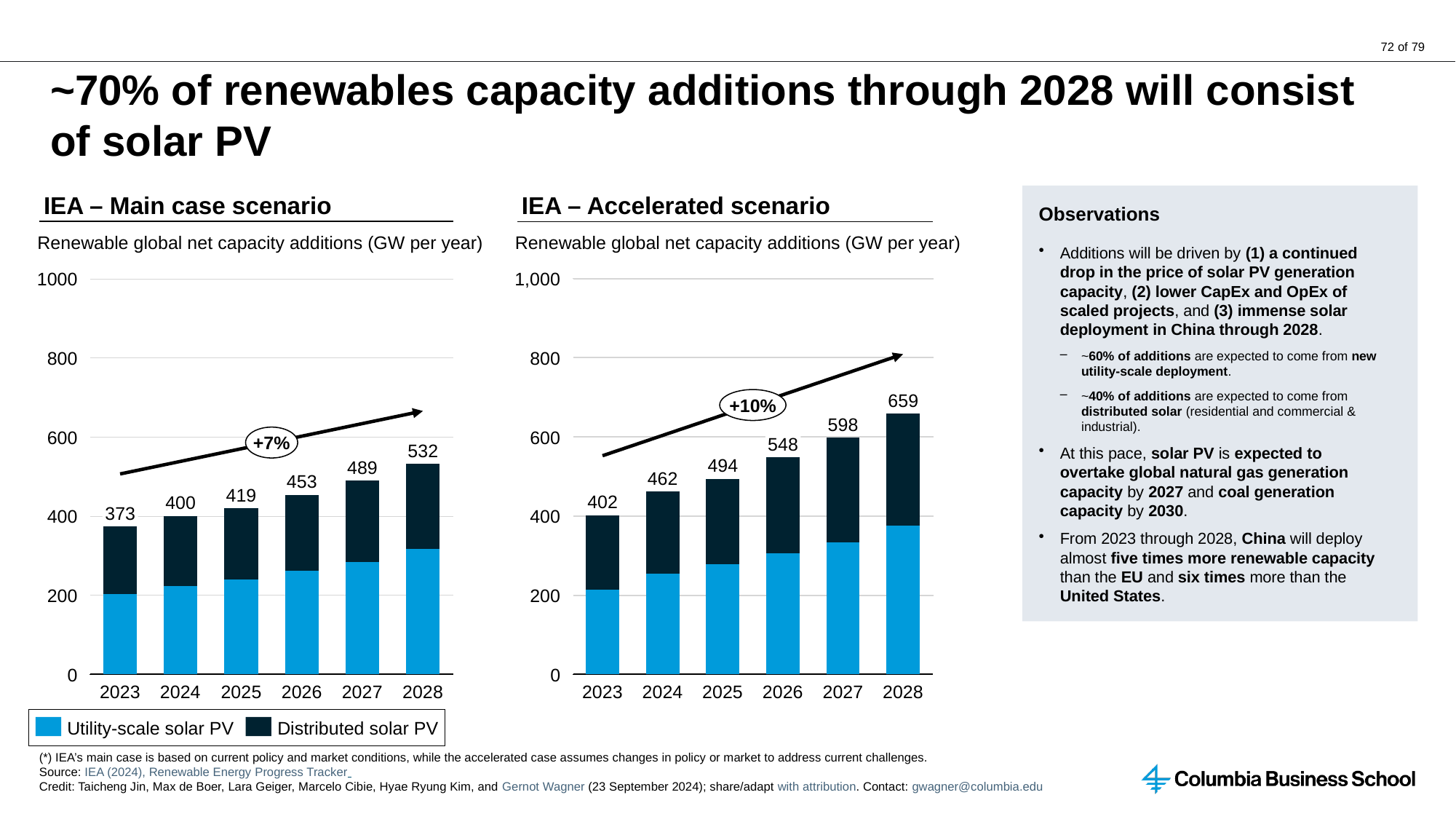
In the IEA – Main case scenario chart, do the total capacity additions rise or fall from 2023 to 2028? Rise In the IEA – Main case scenario chart, which year has the lowest total capacity addition? 2023 In the IEA – Accelerated scenario chart, what is the total renewable net capacity addition labelled for 2023? 402 Which is larger: the 2026 total in the IEA – Main case scenario chart or the 2026 total in the IEA – Accelerated scenario chart? IEA – Accelerated scenario (548) How many years are shown on the x axis of the IEA – Main case scenario chart? 6 In the IEA – Main case scenario chart, what is the difference between the 2028 total and the 2023 total? 159 How many series does the legend list for the charts? 2 In the IEA – Accelerated scenario chart, is the Utility-scale solar PV value for 2028 greater or less than 200? greater In the IEA – Accelerated scenario chart, which year has the highest total capacity addition? 2028 In the IEA – Main case scenario chart, what is the total renewable net capacity addition labelled for 2028? 532 In the IEA – Accelerated scenario chart, what is the difference between the 2027 total and the 2026 total? 50 What kind of chart is the IEA – Accelerated scenario chart? Stacked bar chart